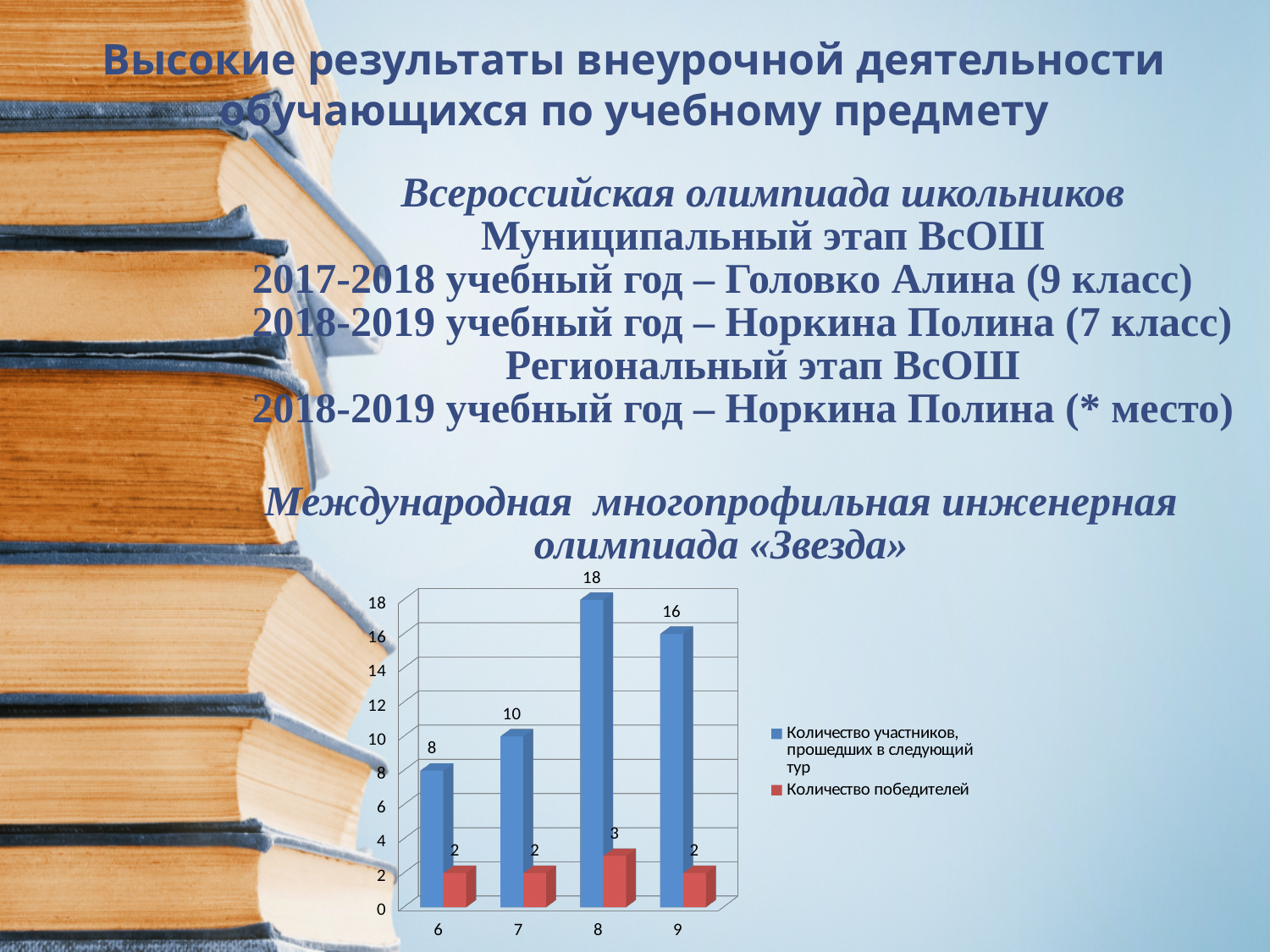
How many categories are shown on the x axis of the chart? 4 What type of chart is shown on the slide? bar chart What is the difference between the 'Количество участников, прошедших в следующий тур' values for categories 8 and 9? 2 What is the value of 'Количество победителей' for category 8? 3 Which series is shown in red in the chart? Количество победителей What is the value of 'Количество победителей' for category 9? 2 Which is larger: 'Количество участников, прошедших в следующий тур' for category 7 or for category 9? 9 How many series does the chart legend list? 2 Which category has the lowest value for 'Количество участников, прошедших в следующий тур'? 6 What is the value of 'Количество участников, прошедших в следующий тур' for category 6? 8 Which category has the highest value for 'Количество участников, прошедших в следующий тур'? 8 What is the value of 'Количество участников, прошедших в следующий тур' for category 8? 18